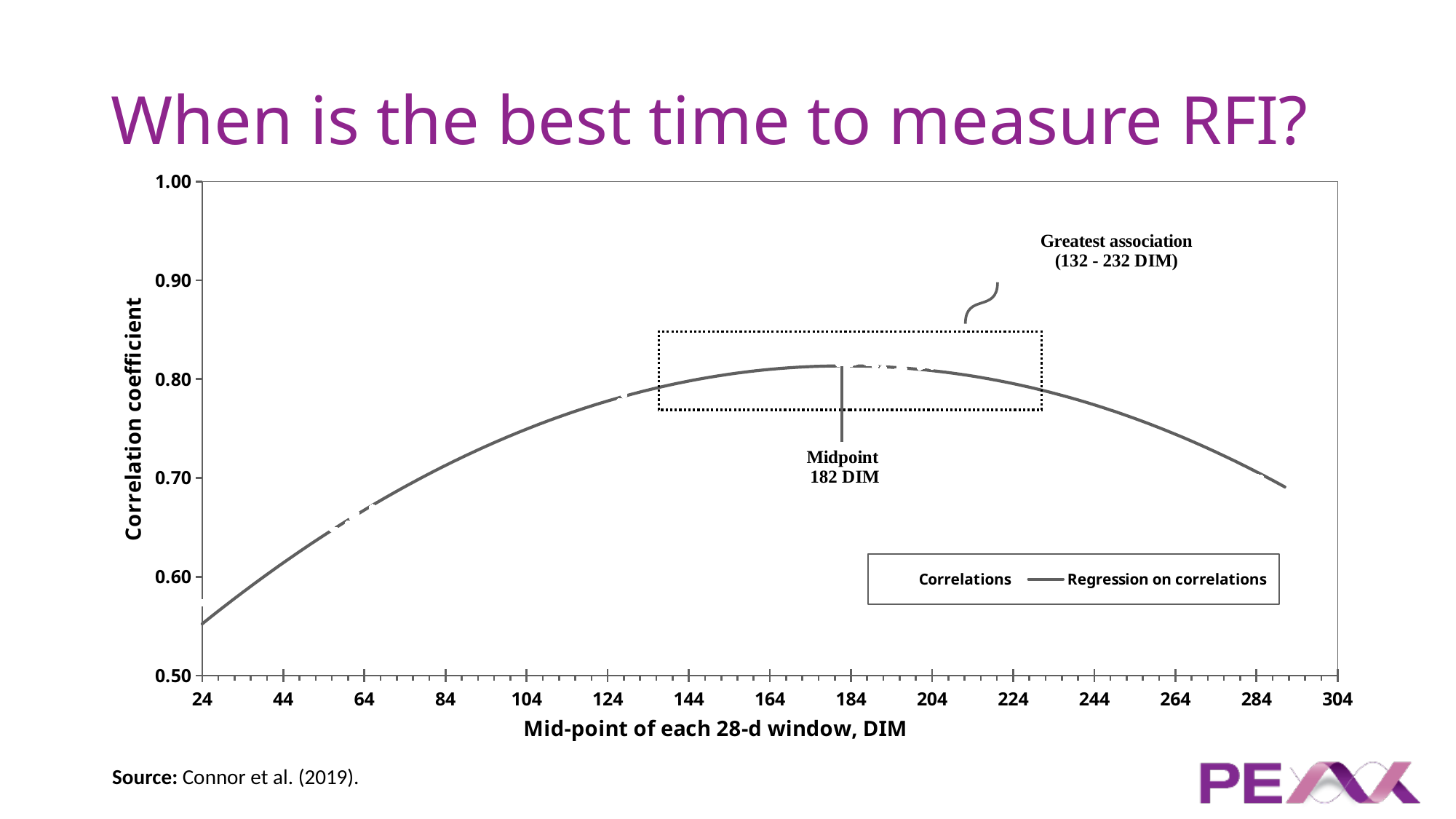
According to the annotation, at which DIM does the regression curve reach its midpoint (peak)? 182 DIM Is the correlation coefficient at 24 DIM greater or less than 0.60? less What are the two entries in the chart legend? Correlations; Regression on correlations According to the annotation, over which DIM range is the greatest association found? 132 - 232 DIM Is the correlation coefficient at 64 DIM greater or less than 0.70? less Is the correlation coefficient at 184 DIM greater or less than 0.80? greater Does the regression curve rise or fall between 24 DIM and 184 DIM? rise What kind of chart is shown on the slide? Line chart Does the regression curve rise or fall between 184 DIM and 284 DIM? fall Which has the higher correlation coefficient on the regression curve: 24 DIM or 284 DIM? 284 DIM How many series does the legend list? 2